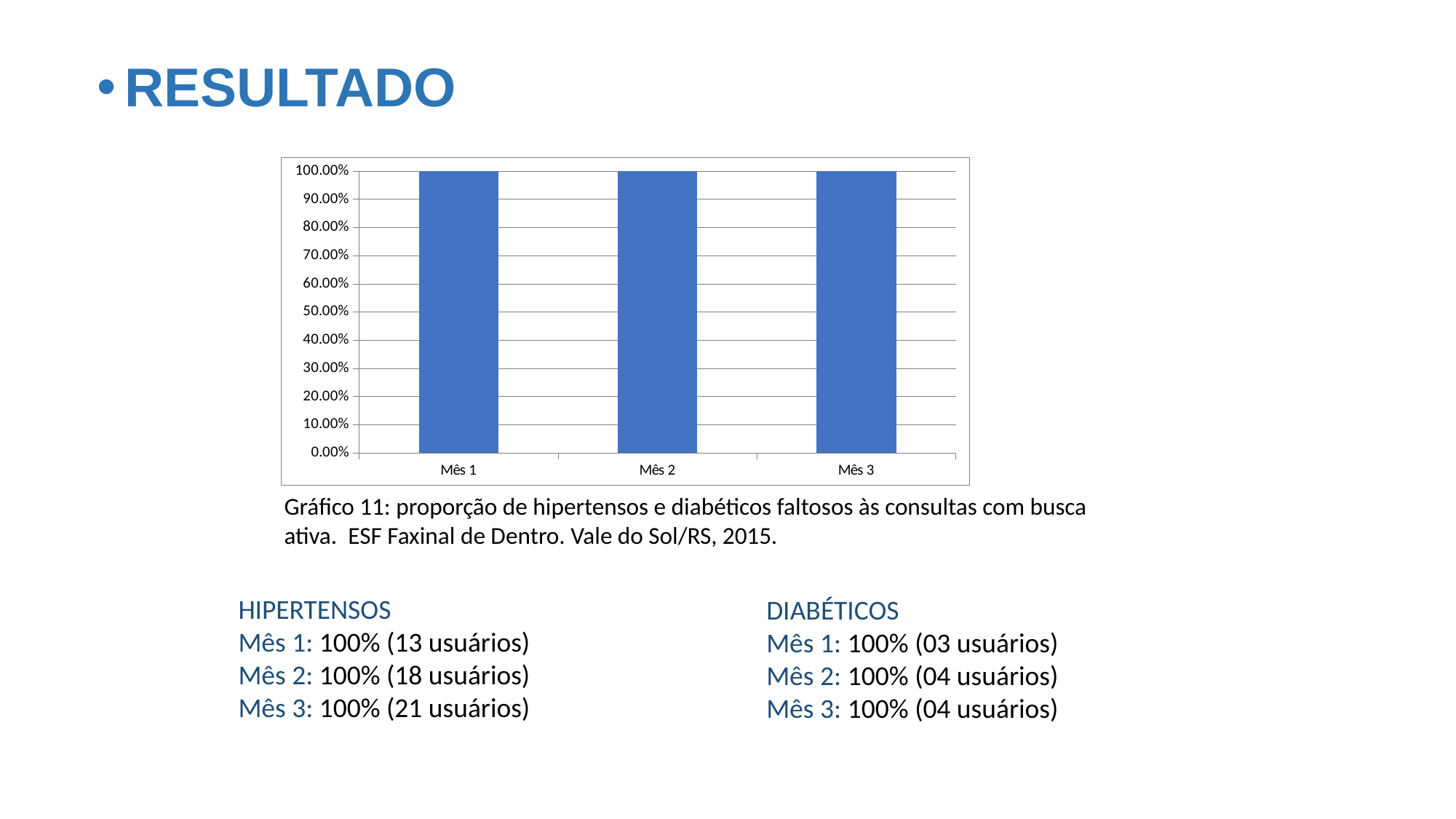
What kind of chart is shown on the slide? bar chart What is the value of the bar for Mês 1? 100.00% Do the values rise, fall, or stay the same from Mês 1 to Mês 3? stay the same What is the value of the bar for Mês 2? 100.00% What is the difference between the values for Mês 1 and Mês 3? 0.00% What is the value of the bar for Mês 3? 100.00% What is the highest value shown on the y axis of the chart? 100.00% What is the label of the first category on the x axis? Mês 1 Is the value for Mês 3 greater or less than 90.00%? greater How many categories are plotted on the x axis of the chart? 3 Is the value for Mês 2 greater or less than 50.00%? greater